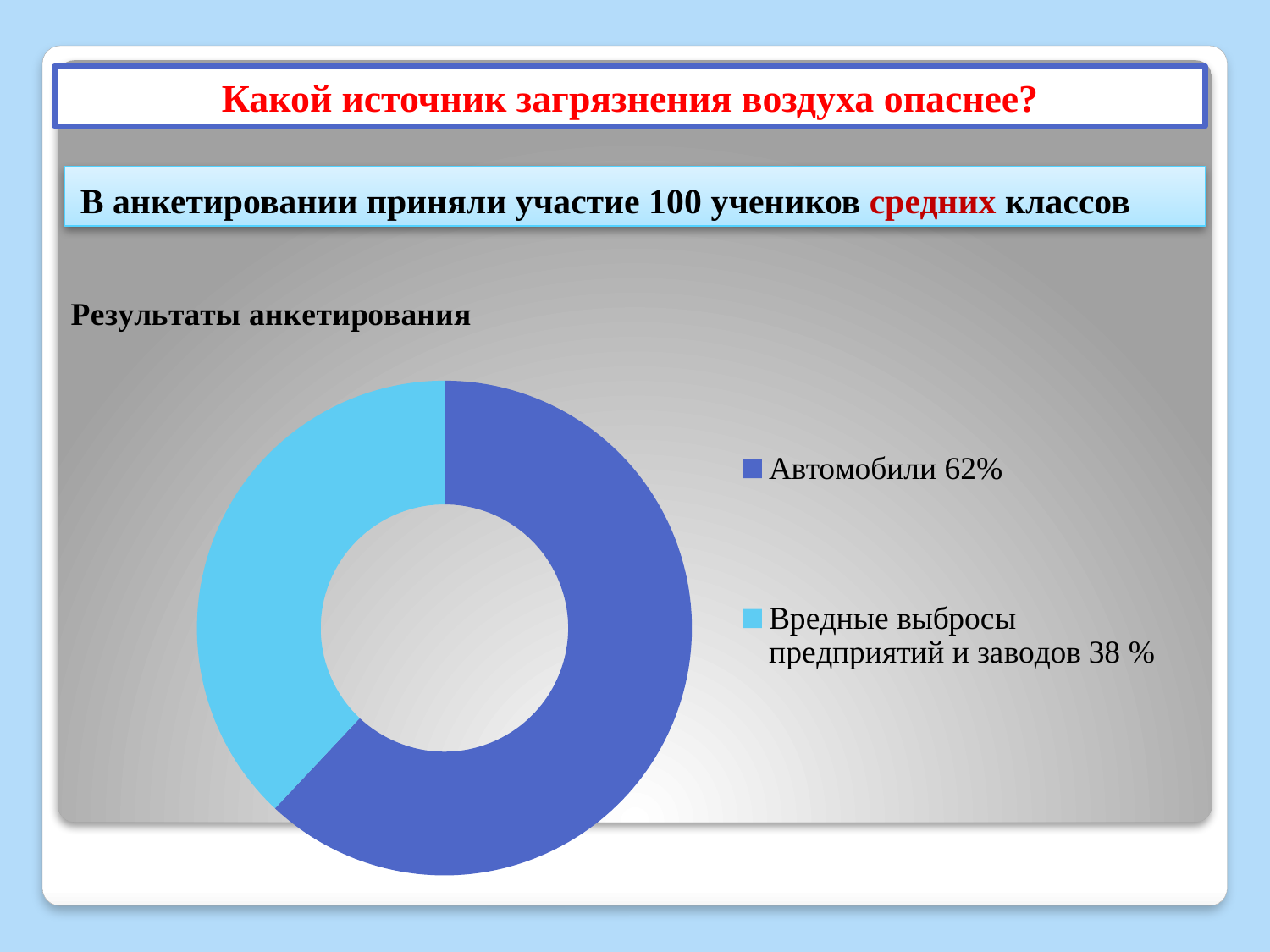
Which category has the smallest share of the chart? Вредные выбросы предприятий и заводов What kind of chart is shown on the slide? Doughnut chart What colour is the slice for Автомобили? Dark blue Which category has the largest share of the chart? Автомобили By how many percentage points does the share for Автомобили exceed the share for Вредные выбросы предприятий и заводов? 24 How many entries does the legend list? 2 How many categories does the chart show? 2 What share of respondents chose Автомобили? 62% What is the heading printed above the chart? Результаты анкетирования Is the share for Автомобили greater or less than 50%? greater What share of respondents chose Вредные выбросы предприятий и заводов? 38 % Which is larger: the share for Автомобили or the share for Вредные выбросы предприятий и заводов? Автомобили